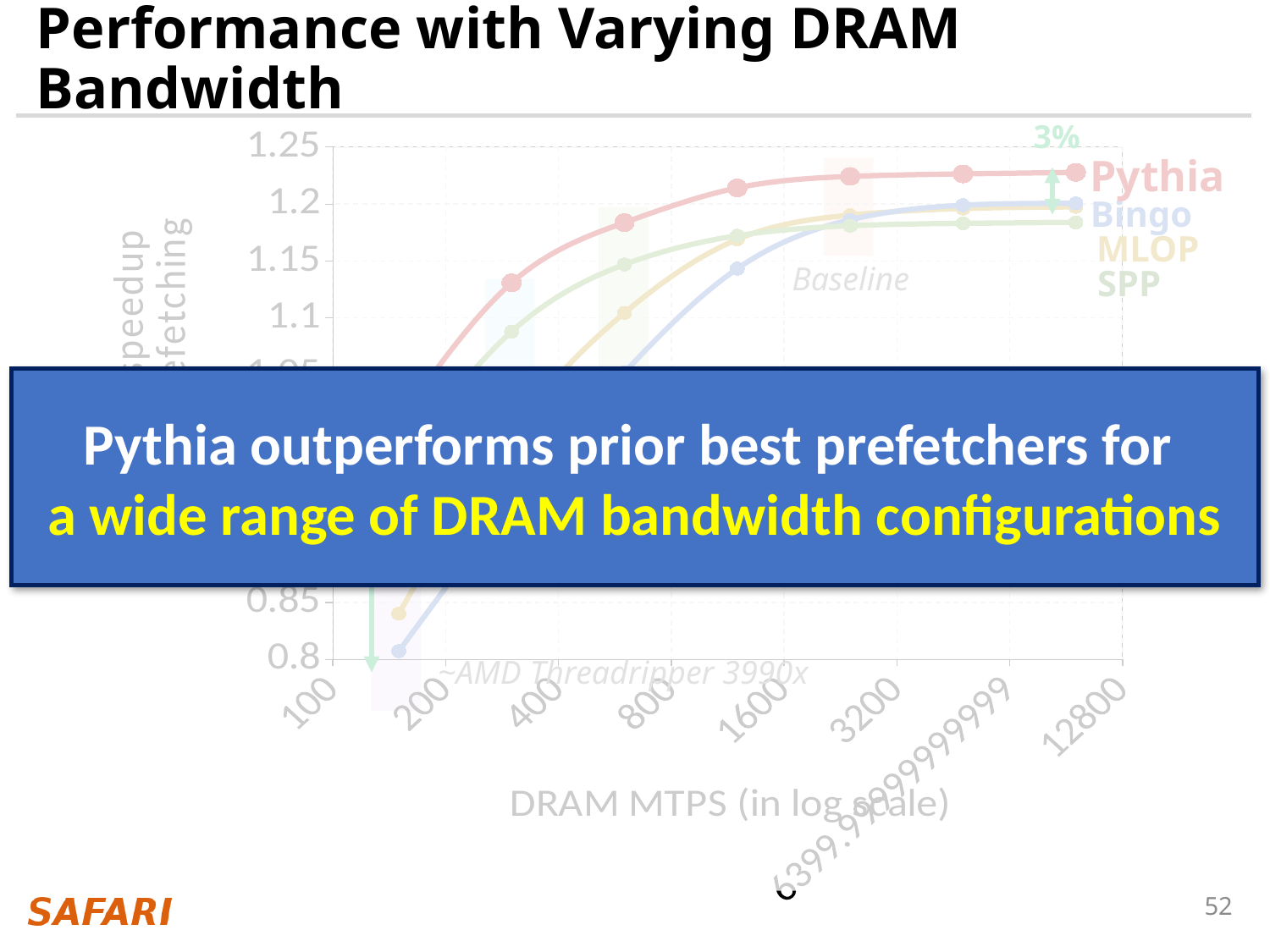
Does the speedup for Pythia rise or fall as DRAM MTPS increases? rise What kind of chart is shown on the slide? line chart Which series has the highest speedup at 12800 DRAM MTPS? Pythia Is the speedup for Pythia at 12800 DRAM MTPS greater or less than 1.2? greater At 400 DRAM MTPS, which has the higher speedup, Pythia or SPP? Pythia Is the speedup for Bingo at 1600 DRAM MTPS greater or less than 1.1? greater What percentage is annotated above the Pythia line at the right end of the chart? 3% Is the speedup for SPP at 12800 DRAM MTPS greater or less than 1.2? less How many series (prefetchers) are plotted in the chart? 4 Which series has the lowest speedup at 800 DRAM MTPS? Bingo What is the title of the x axis of the chart? DRAM MTPS (in log scale)